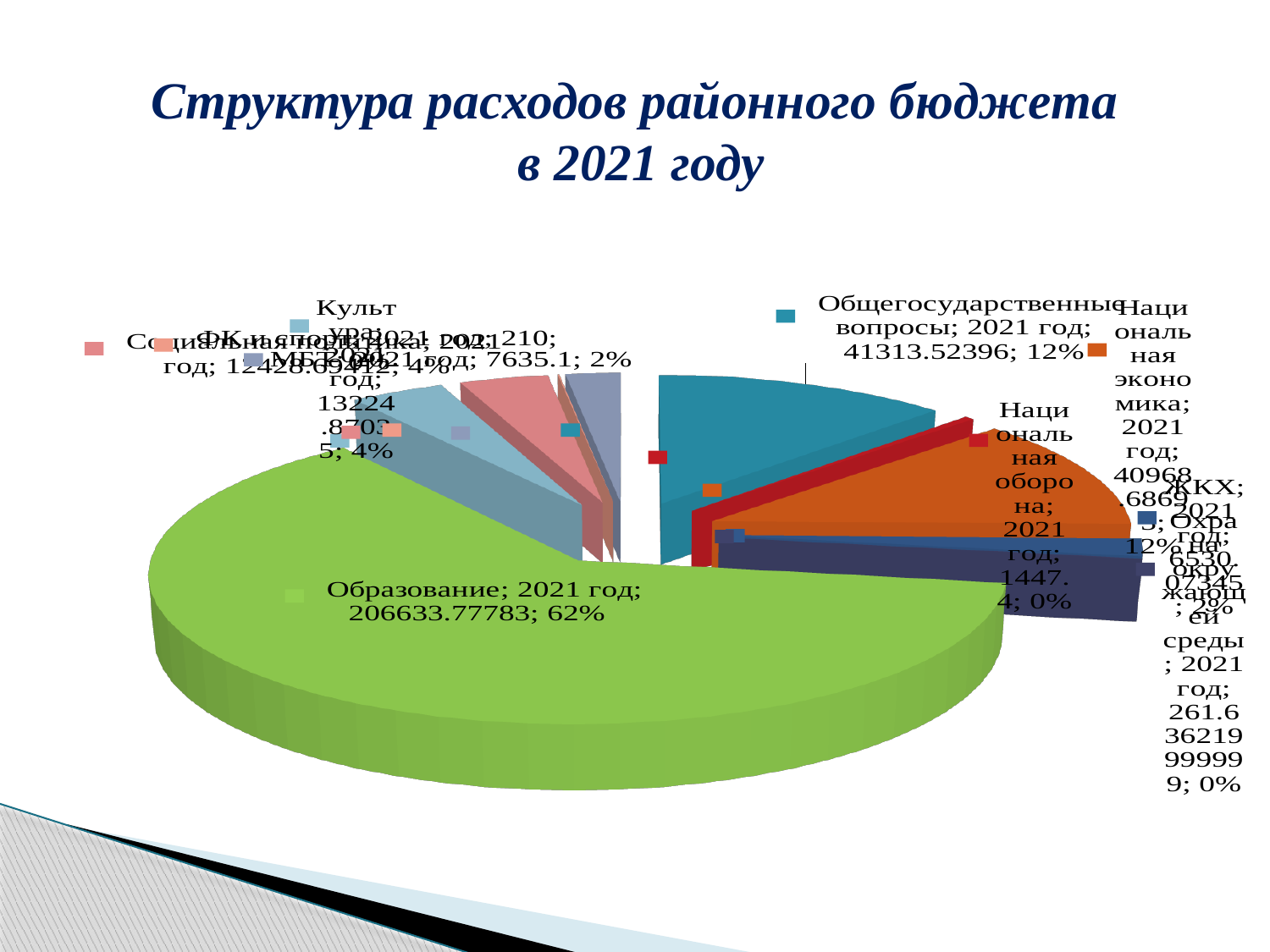
What value is shown for Образование? 206633.77783 What share of the pie does Общегосударственные вопросы take? 12% What share of the pie does Образование take? 62% Which is larger, the value for Образование or the value for Общегосударственные вопросы? Образование What share of the pie does Национальная оборона take? 0% What value is shown for Общегосударственные вопросы? 41313.52396 What value is shown for Национальная оборона? 1447.4 What is the title of the chart on the slide? Структура расходов районного бюджета в 2021 году Which category has the smallest slice of the pie? ФК и спорт Which category has the largest slice of the pie? Образование What is the difference between the value for Образование and the value for Общегосударственные вопросы? 165320.25387 What kind of chart is shown on the slide? pie chart